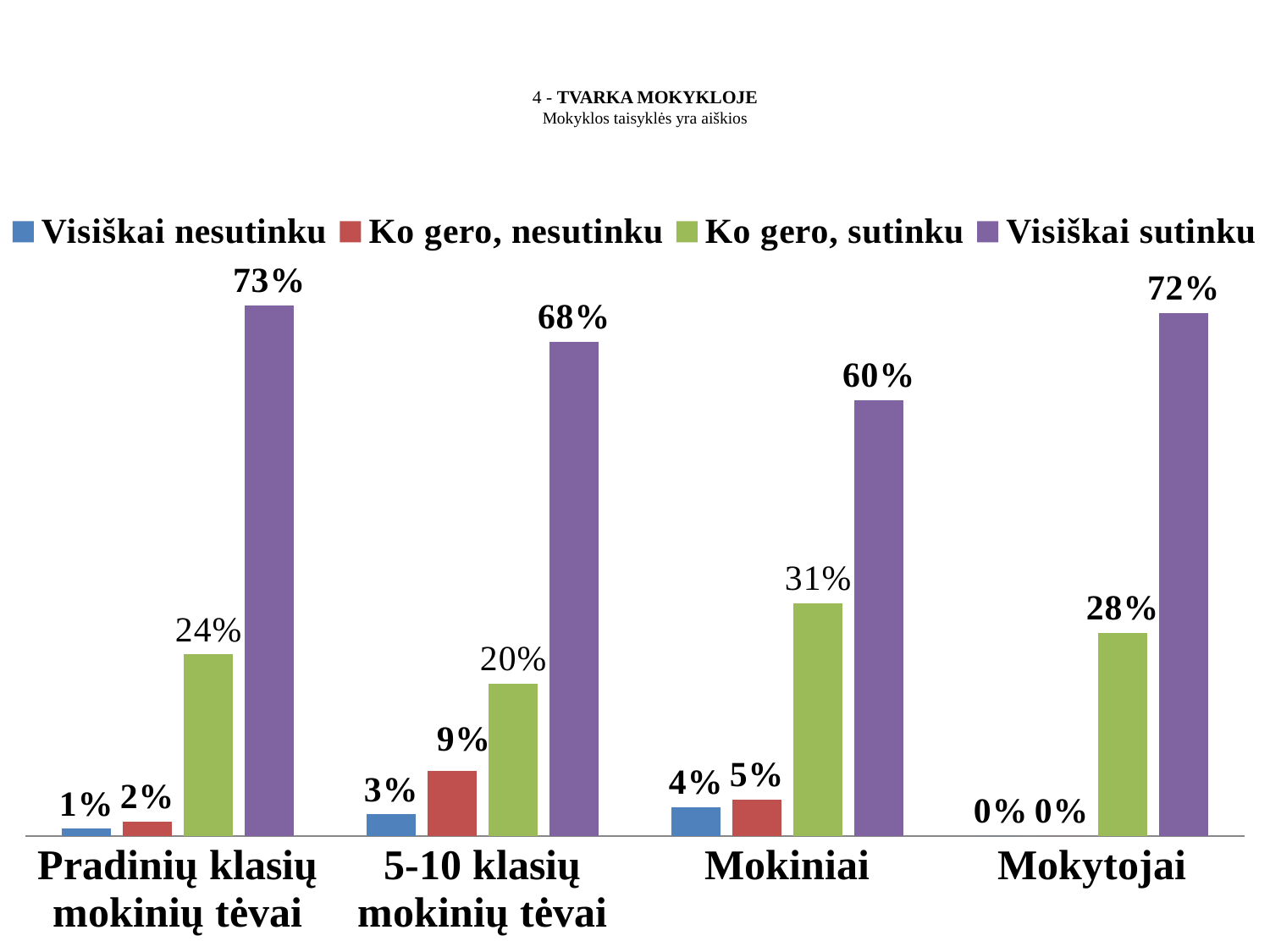
Which category has the highest value for "Visiškai sutinku"? Pradinių klasių mokinių tėvai What is the value for "Visiškai sutinku" in the "Pradinių klasių mokinių tėvai" category? 73% Which category has the lowest value for "Visiškai sutinku"? Mokiniai How many categories are shown on the x axis? 4 How many series does the legend list? 4 Which is larger: "Ko gero, sutinku" for "Mokiniai" or for "Mokytojai"? Mokiniai What is the value for "Visiškai nesutinku" in the "Mokytojai" category? 0% What kind of chart is shown on the slide? Bar chart What is the subtitle text shown under the chart title "4 - TVARKA MOKYKLOJE"? Mokyklos taisyklės yra aiškios What is the value for "Ko gero, sutinku" in the "Mokiniai" category? 31% What is the value for "Ko gero, nesutinku" in the "5-10 klasių mokinių tėvai" category? 9% What is the difference between the "Visiškai sutinku" values for "Pradinių klasių mokinių tėvai" and "Mokiniai"? 13%